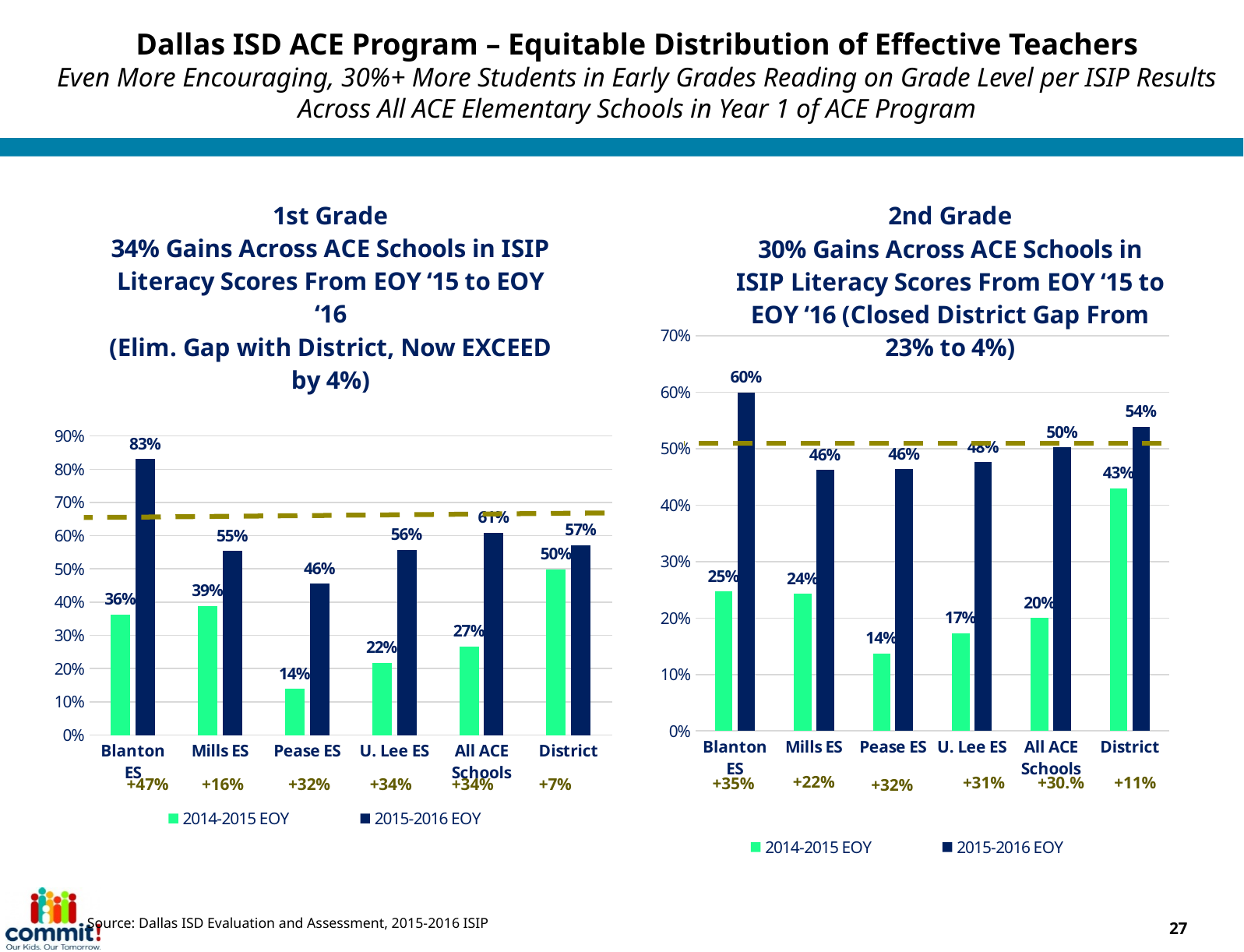
In the 1st Grade chart, what is the 2014-2015 EOY value for Pease ES? 14% How many series does the legend of the 1st Grade chart list? 2 In the 1st Grade chart, what is the 2015-2016 EOY value for Blanton ES? 83% In the 1st Grade chart, what is the difference between the 2015-2016 EOY and 2014-2015 EOY values for Mills ES? 16% In the 2nd Grade chart, what is the 2015-2016 EOY value for Blanton ES? 60% In the 1st Grade chart, which category has the highest 2015-2016 EOY value? Blanton ES In the 2nd Grade chart, which is larger: the 2015-2016 EOY value for District or for All ACE Schools? District In the 2nd Grade chart, is the 2015-2016 EOY value for Mills ES greater or less than 50%? less In the 2nd Grade chart, what is the 2014-2015 EOY value for District? 43% In the 1st Grade chart, which category has the lowest 2014-2015 EOY value? Pease ES In the 2nd Grade chart, which category has the lowest 2014-2015 EOY value? Pease ES How many categories are shown on the x axis of the 2nd Grade chart? 6